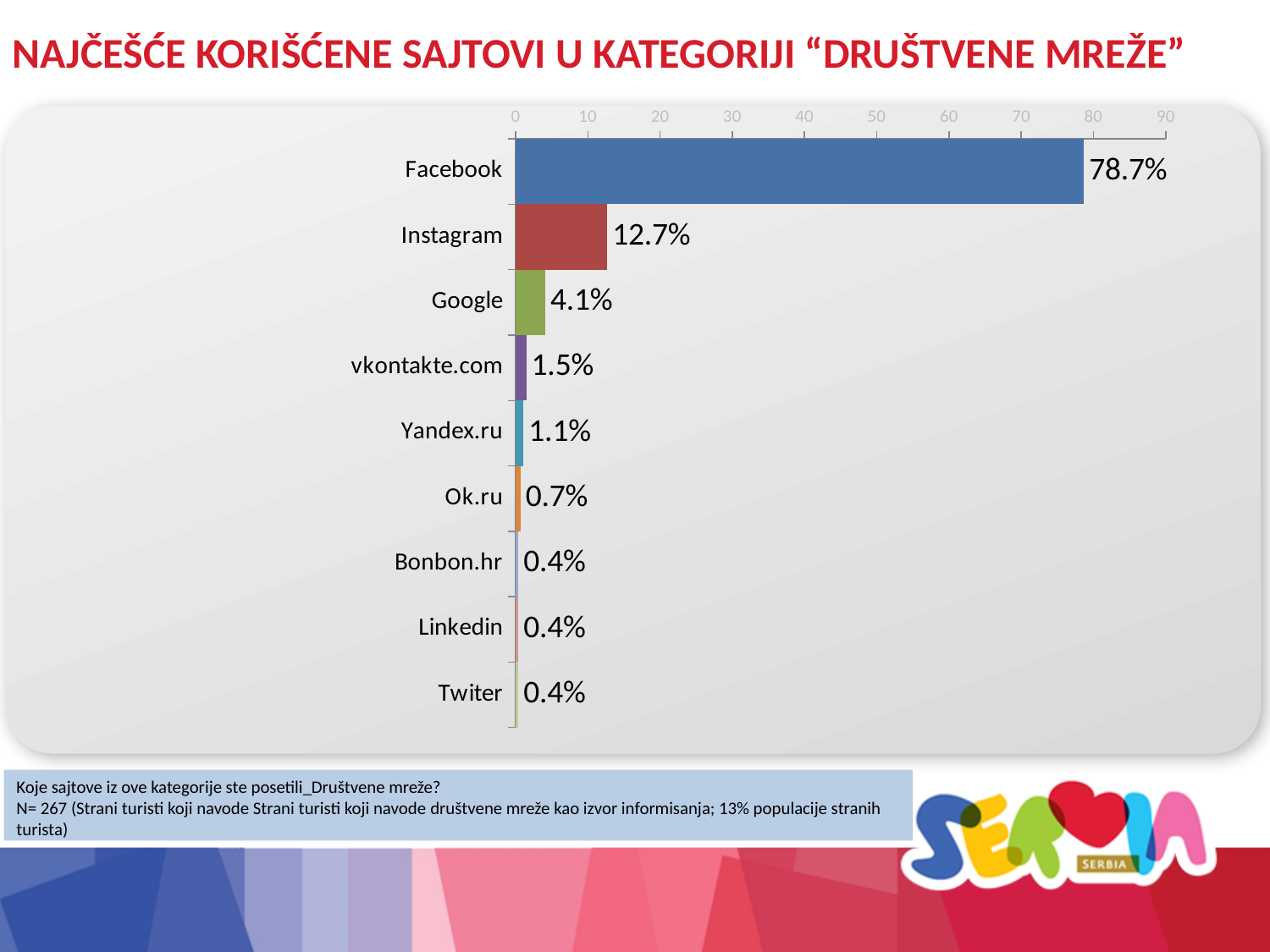
What is the title of the slide? NAJČEŠĆE KORIŠĆENE SAJTOVI U KATEGORIJI "DRUŠTVENE MREŽE" What is the difference between the values for Google and Yandex.ru? 3% Is the value for Instagram greater or less than 10? greater What is the difference between the values for Facebook and Instagram? 66% What is the value for Instagram? 12.7% What is the value for Facebook? 78.7% Which is larger, the value for Google or the value for vkontakte.com? Google What is the value for vkontakte.com? 1.5% How many sites are shown in the chart? 9 Which site has the highest value? Facebook What kind of chart is shown on the slide? bar chart What is the value for Ok.ru? 0.7%